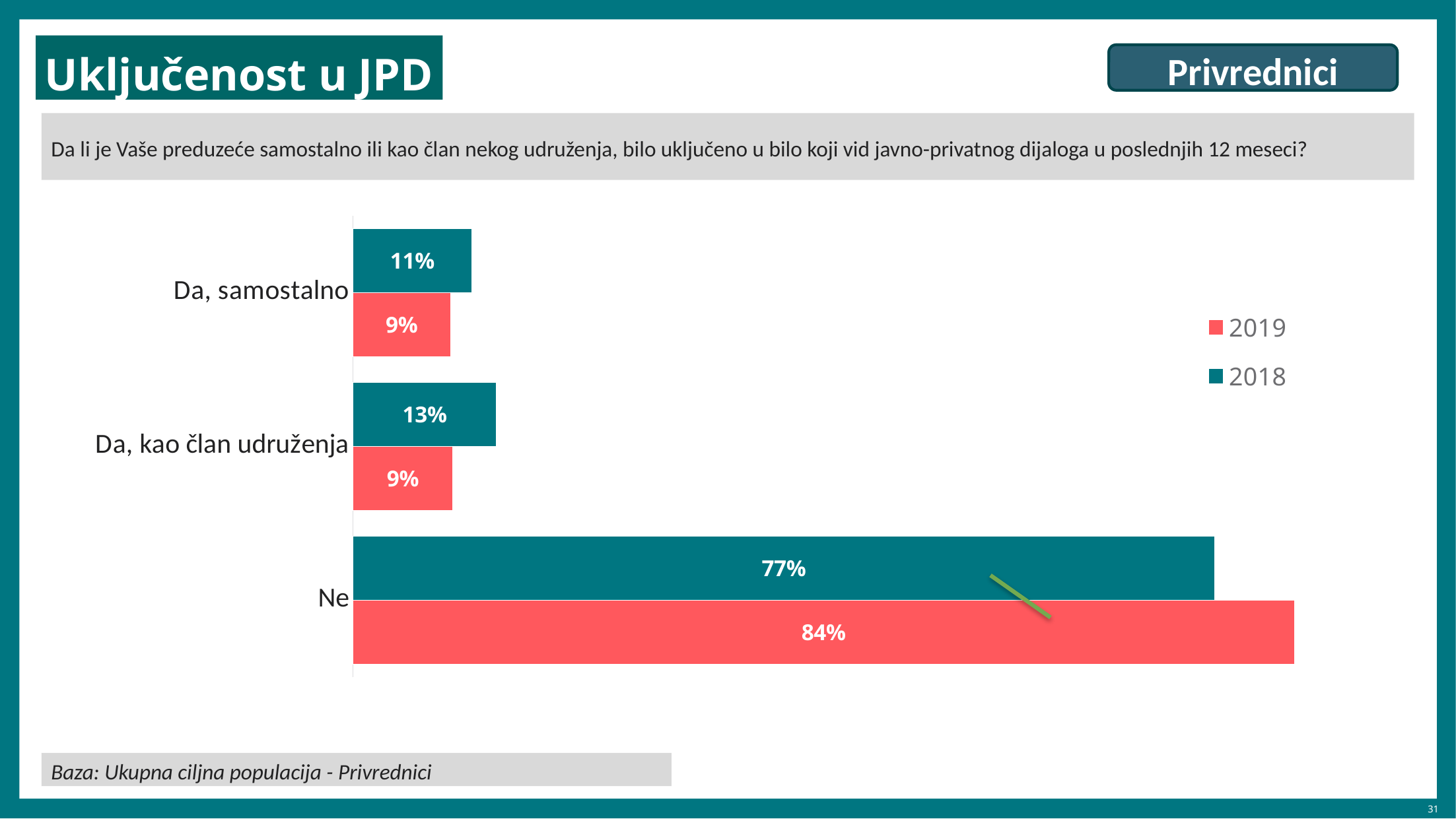
How many categories are shown on the chart? 3 What is the difference between the 2019 and 2018 values for "Ne"? 7% What is the value for "Da, samostalno" in the 2019 series? 9% What is the value for "Da, kao član udruženja" in the 2018 series? 13% What kind of chart is shown on the slide? Bar chart What is the value for "Ne" in the 2019 series? 84% What is the value for "Da, samostalno" in the 2018 series? 11% How many series does the legend list? 2 Which is larger for "Ne": the 2019 value or the 2018 value? 2019 Which category has the highest value in the 2018 series? Ne What is the difference between the 2018 and 2019 values for "Da, kao član udruženja"? 4% Which category has the lowest value in the 2018 series? Da, samostalno